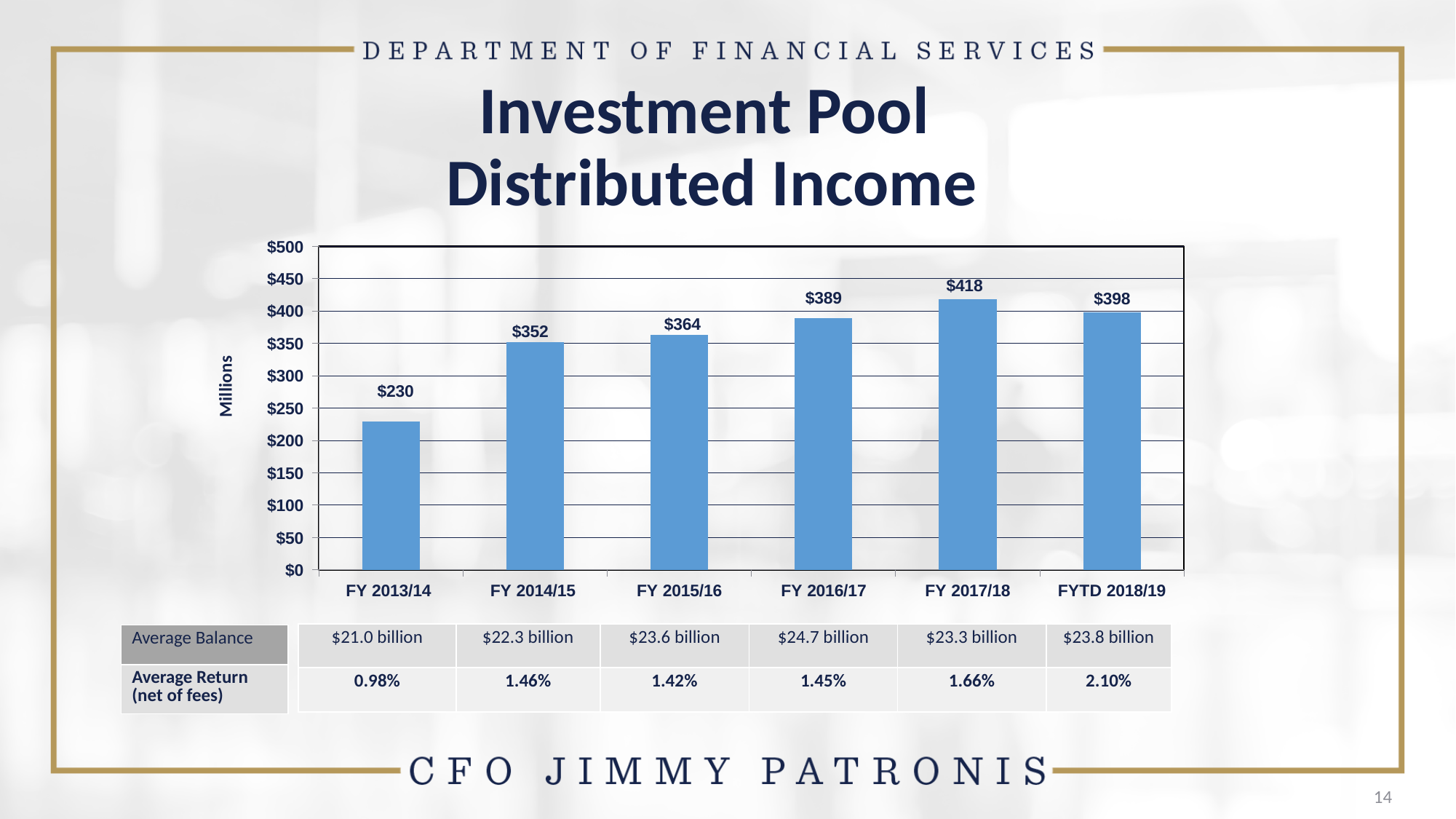
What kind of chart is shown on the slide? bar chart What is the difference in distributed income between FY 2017/18 and FY 2013/14? $188 What is the distributed income for FY 2013/14? $230 What is the distributed income for FY 2016/17? $389 What is the difference in distributed income between FY 2015/16 and FY 2014/15? $12 Which fiscal year has the lowest distributed income? FY 2013/14 What unit is shown on the vertical axis label of the chart? Millions Which fiscal year has the highest distributed income? FY 2017/18 What is the distributed income for FYTD 2018/19? $398 Which is larger, the distributed income for FY 2016/17 or FYTD 2018/19? FYTD 2018/19 How many fiscal years are shown on the chart? 6 Is the distributed income for FY 2014/15 greater or less than $300? greater